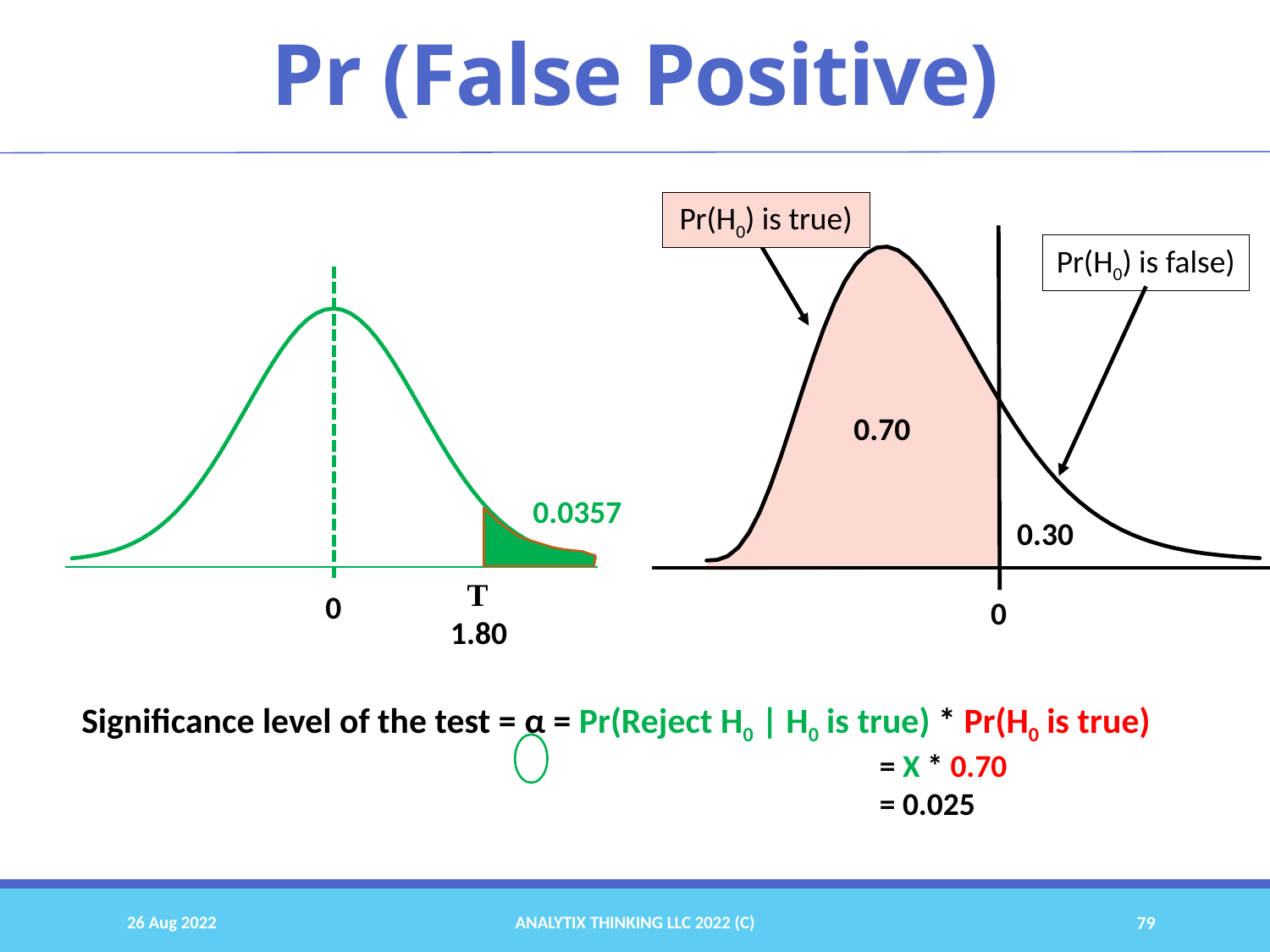
What kind of chart is shown on the left of the slide? a bell-shaped distribution curve with a shaded tail area On the right chart, what is the total of the two printed region values? 1.00 On the right chart, what value is printed in the unshaded region to the right of the vertical line? 0.30 On the left chart, what value is printed at the centre of the x axis under the dashed line? 0 On the left chart, what value is printed below the threshold T on the x axis? 1.80 On the right chart, what does the label pointing to the shaded region say? Pr(H0) is true On the right chart, what value is printed inside the pink shaded region? 0.70 How many distribution curves are drawn on the slide? 2 On the right chart, what is the difference between the two printed region values, 0.70 and 0.30? 0.40 On the left chart, what value is printed next to the green shaded tail area? 0.0357 What is the title of the slide? Pr (False Positive) On the right chart, which region has the larger printed value, the shaded region or the unshaded region? the shaded region